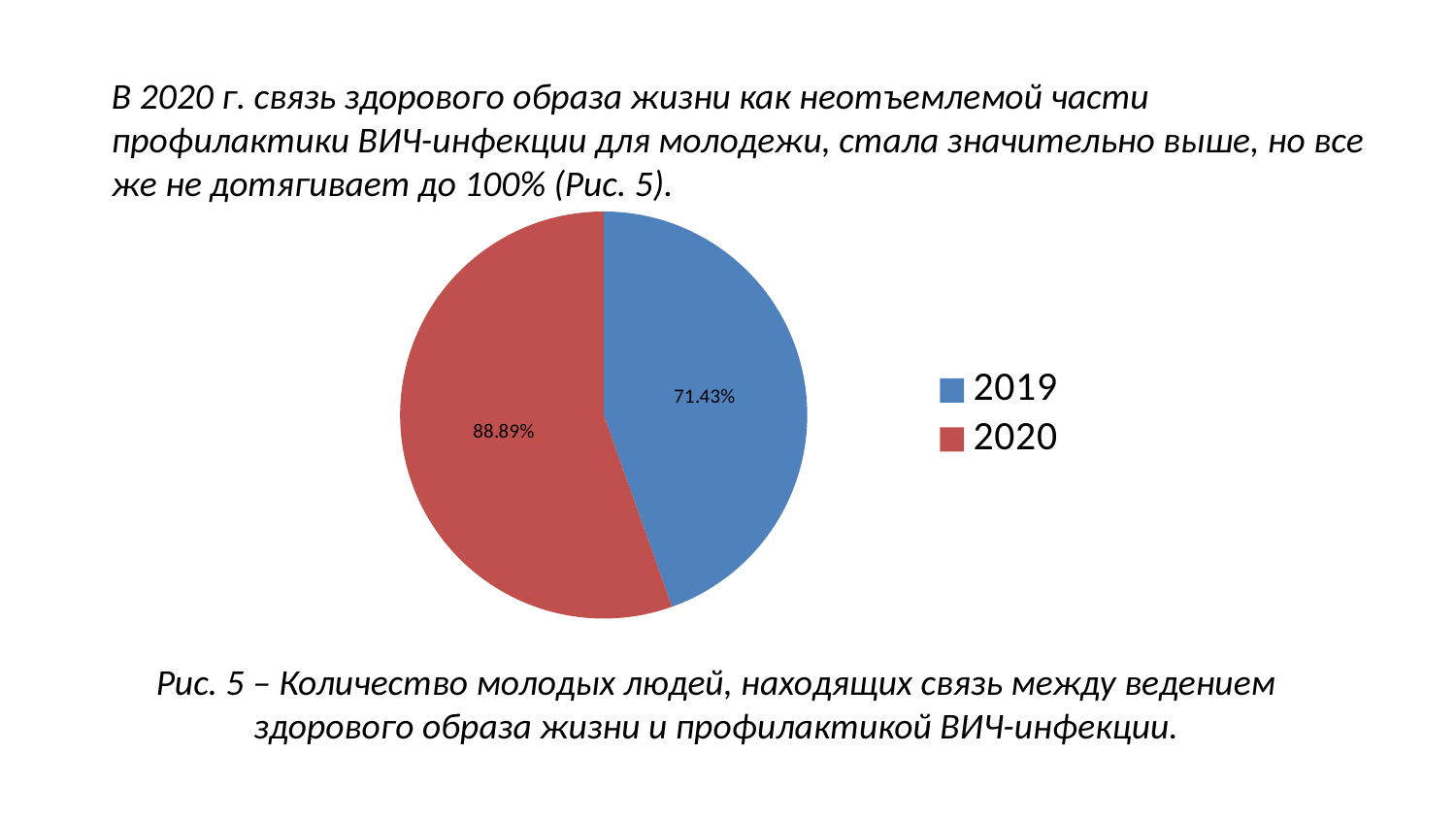
How many entries does the legend list? 2 Did the value increase or decrease from 2019 to 2020? Increase Which year has the higher value in the pie chart? 2020 How many slices does the pie chart have? 2 Which year has the lower value in the pie chart? 2019 Which colour represents 2019 in the pie chart? Blue What value is shown for 2019 in the pie chart? 71.43% What value is shown for 2020 in the pie chart? 88.89% Which colour represents 2020 in the pie chart? Red What kind of chart is shown on the slide? Pie chart Is the value for 2020 larger or smaller than the value for 2019? Larger What is the difference between the values for 2020 and 2019? 17.46 percentage points